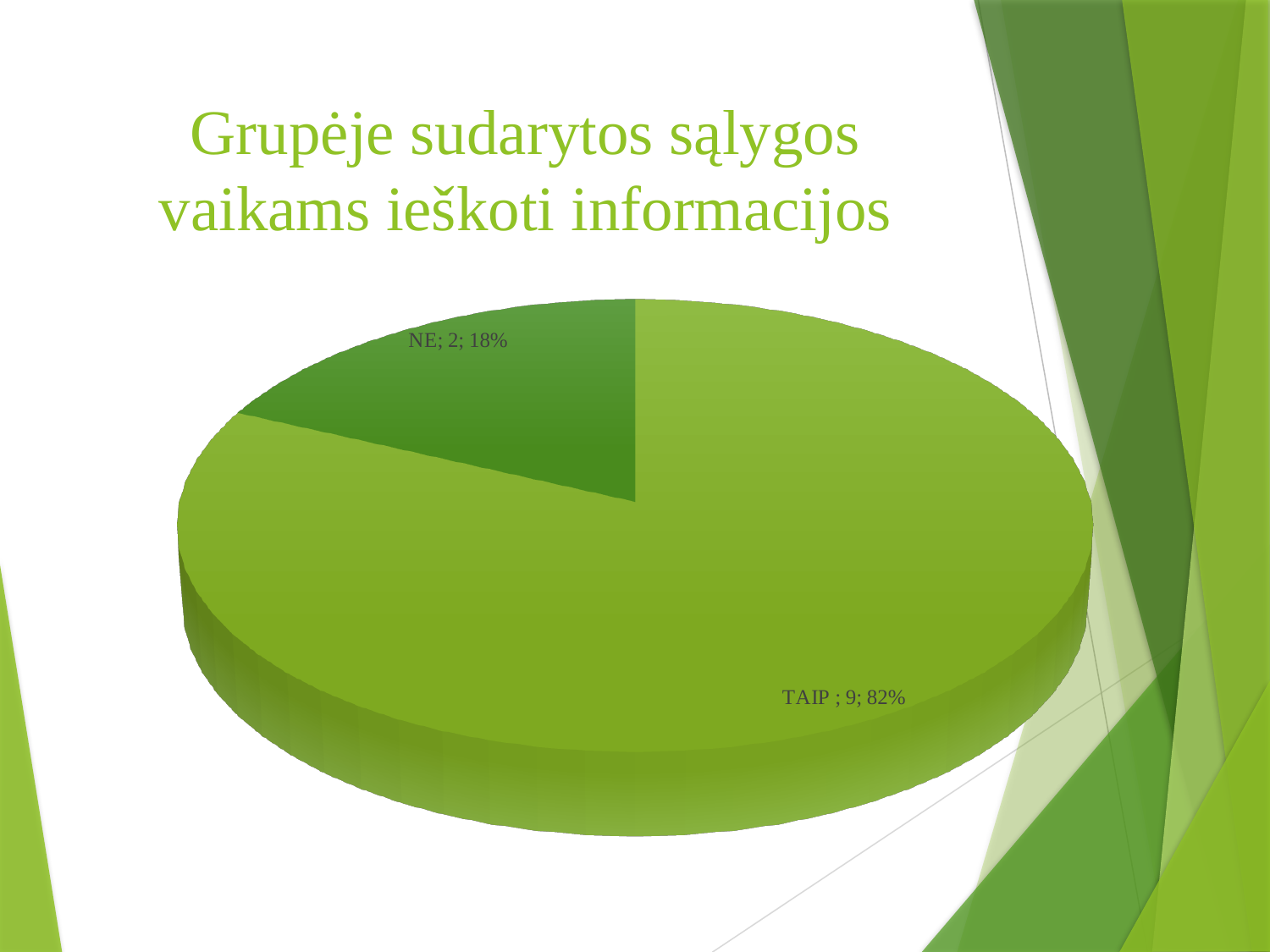
What is the title of the slide containing the chart? Grupėje sudarytos sąlygos vaikams ieškoti informacijos How many slices does the pie chart have? 2 Which category has the largest slice? TAIP What is the value for TAIP? 9 Which is larger, the value for TAIP or the value for NE? TAIP What is the total of the values for TAIP and NE? 11 What share of the pie does TAIP represent? 82% What kind of chart is shown on the slide? pie chart What is the difference between the values for TAIP and NE? 7 What share of the pie does NE represent? 18% What is the value for NE? 2 Which category has the smallest slice? NE